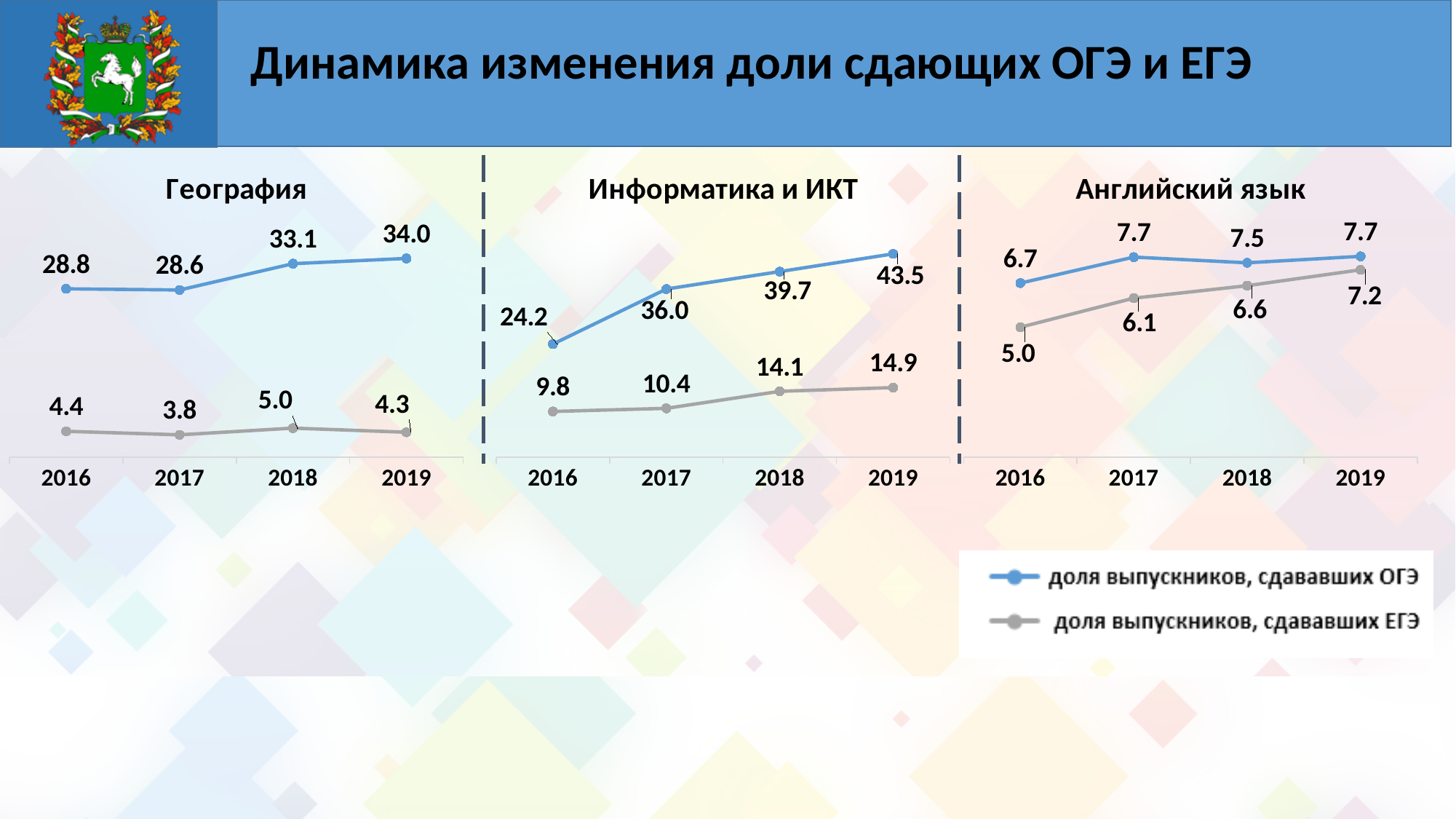
In the "Английский язык" chart, what is the value for "доля выпускников, сдававших ЕГЭ" in 2016? 5.0 In the "Английский язык" chart, does the ЕГЭ series rise or fall from 2016 to 2019? rise In the "Информатика и ИКТ" chart, in which year is the value for "доля выпускников, сдававших ОГЭ" lowest? 2016 In the "Английский язык" chart, which is larger in 2018: the ОГЭ value or the ЕГЭ value? ОГЭ In the "География" chart, in which year is the value for "доля выпускников, сдававших ЕГЭ" highest? 2018 In the "Информатика и ИКТ" chart, does the ОГЭ series rise or fall from 2016 to 2019? rise What kind of chart is the "География" chart? line chart In the "География" chart, what is the value for "доля выпускников, сдававших ОГЭ" in 2019? 34.0 In the "Информатика и ИКТ" chart, what is the difference between the ОГЭ values in 2019 and 2016? 19.3 How many series does the legend list? 2 In the "География" chart, what is the difference between the ОГЭ value and the ЕГЭ value in 2016? 24.4 In the "Информатика и ИКТ" chart, what is the value for "доля выпускников, сдававших ЕГЭ" in 2018? 14.1